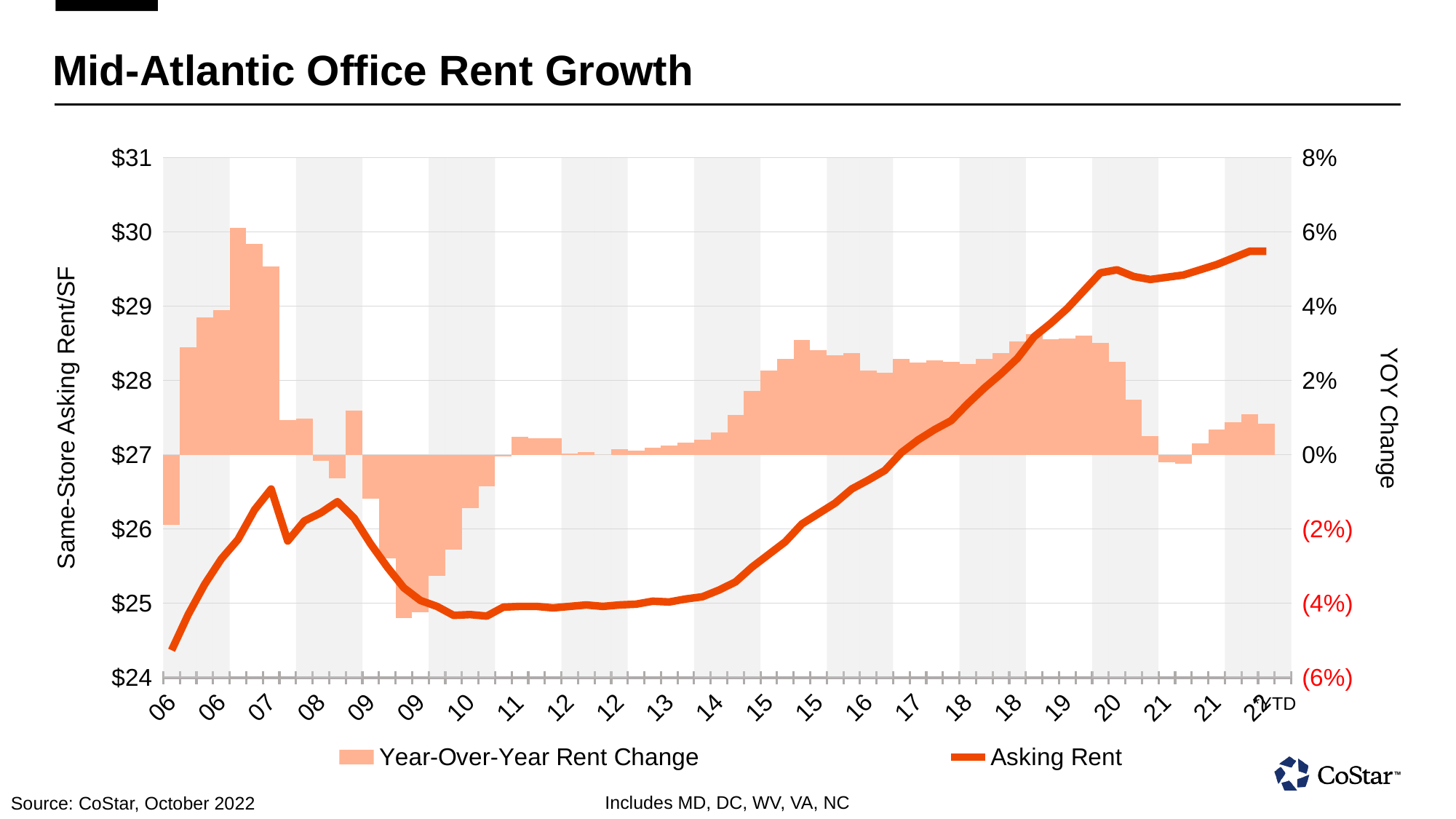
Is the peak Year-Over-Year Rent Change bar around 2006-07 greater or less than 4%? greater What kind of chart is shown on the slide? A combined bar and line chart Is the Asking Rent value at 22 YTD greater or less than $29? greater Does the Asking Rent line rise or fall between 2014 and 2020? rise Is the Asking Rent value at the start of the series (06) greater or less than $25? less Which is larger, the Asking Rent in 2020 or the Asking Rent in 2010? 2020 At which point on the x axis is the Asking Rent line at its highest? 22 YTD How many series does the legend list? 2 What are the two series named in the legend? Year-Over-Year Rent Change and Asking Rent At which point on the x axis is the Asking Rent line at its lowest? 06 (the first point) What is the title of the chart? Mid-Atlantic Office Rent Growth